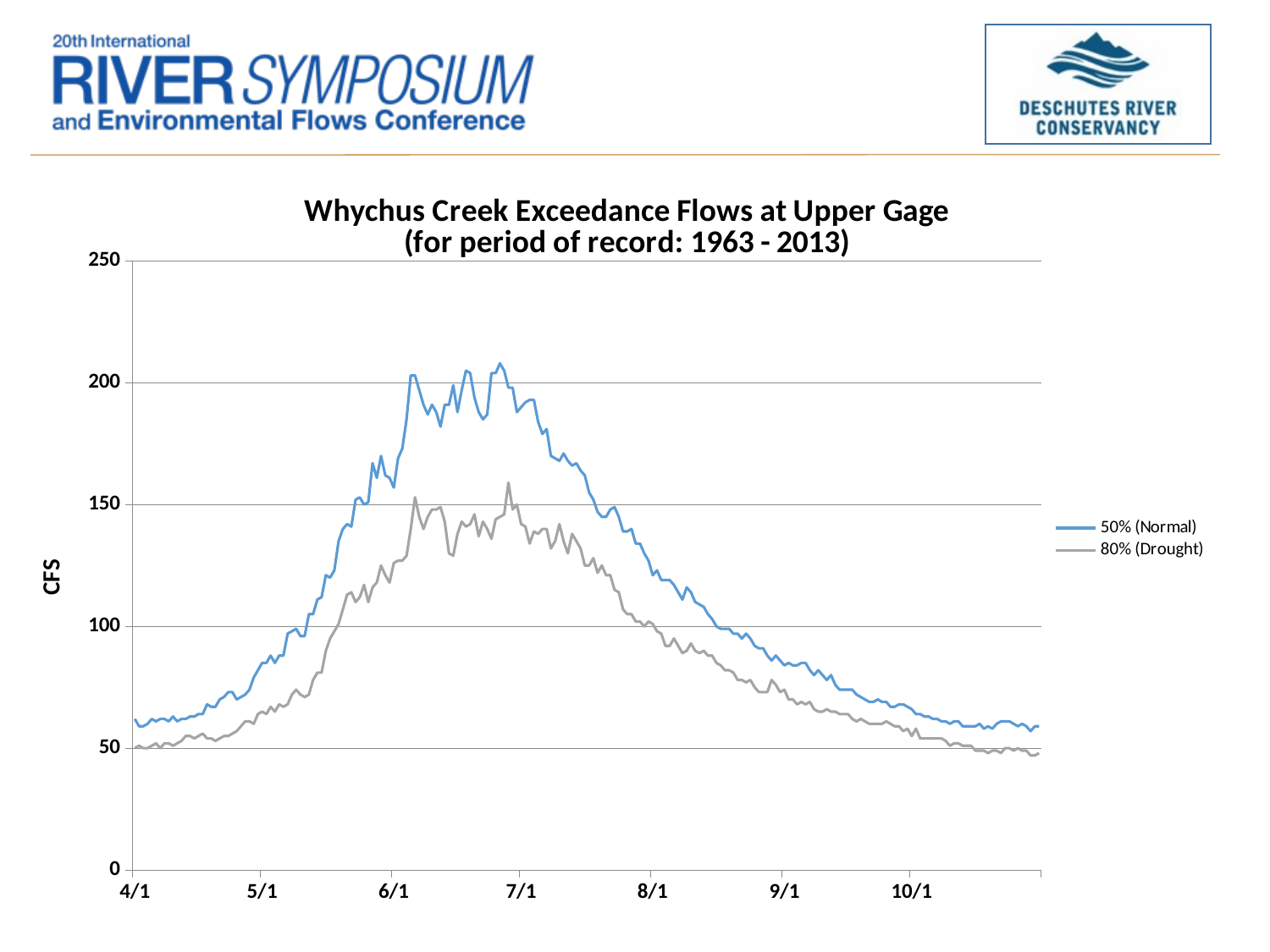
What is the label on the vertical axis? CFS Is the peak value of the 80% (Drought) line greater or less than 200? less Is the value of the 80% (Drought) line at 4/1 greater or less than 100? less Do the values of the 50% (Normal) line rise or fall between 7/1 and 10/1? fall Is the value of the 80% (Drought) line at 9/1 greater or less than 100? less What is the title of the chart? Whychus Creek Exceedance Flows at Upper Gage (for period of record: 1963 - 2013) Do the values of the 80% (Drought) line rise or fall between 4/1 and 6/1? rise How many series does the legend list? 2 Which series has the higher value at 7/1, 50% (Normal) or 80% (Drought)? 50% (Normal) What kind of chart is shown on the slide? line chart